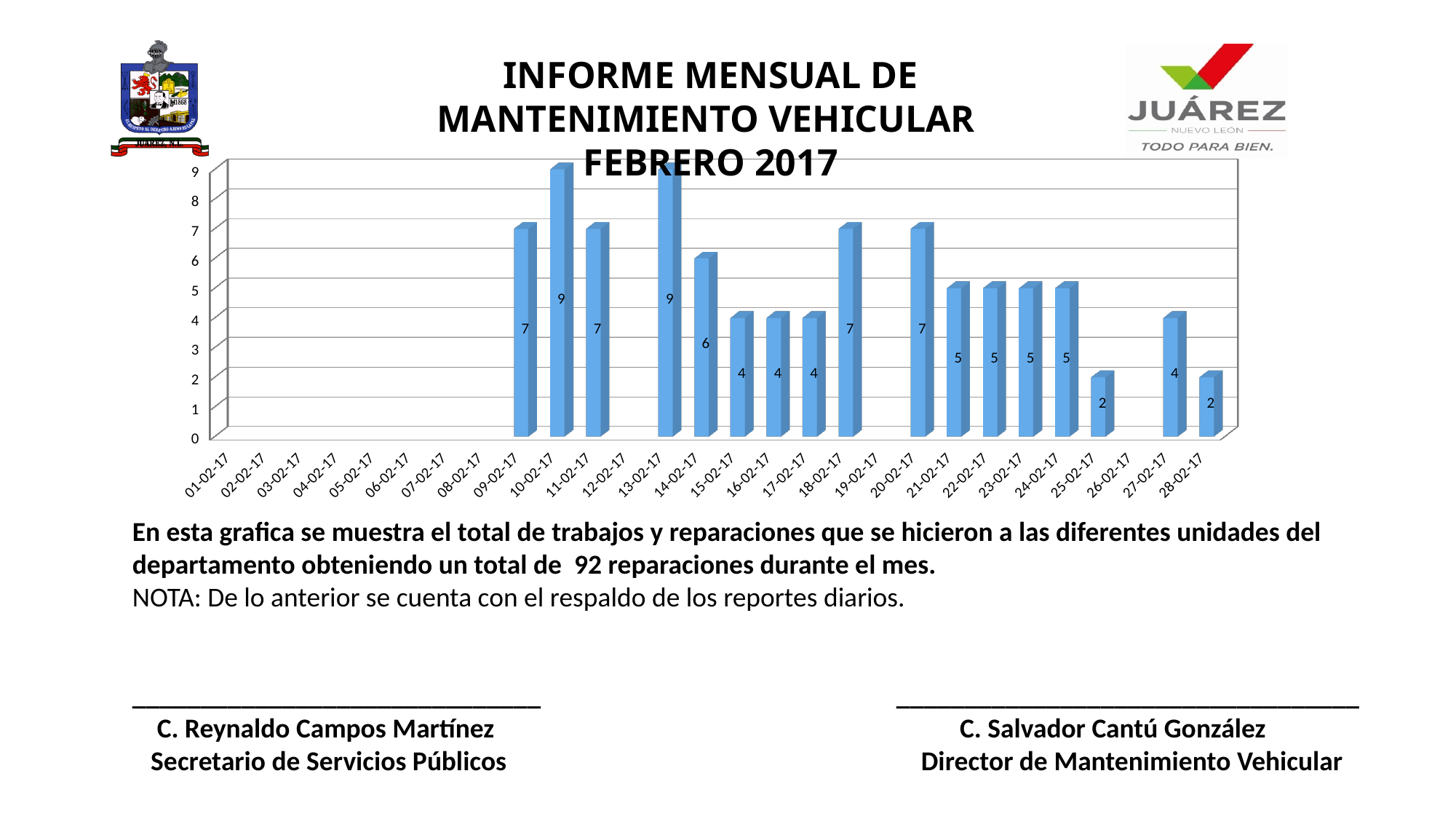
What type of chart is shown on the slide? bar chart What is the value for 27-02-17? 4 How many dates are listed along the x axis? 28 What is the highest value shown by any bar in the chart? 9 What is the value for 18-02-17? 7 What is the difference between the values for 10-02-17 and 14-02-17? 3 What is the value for 25-02-17? 2 Which two dates share the highest value in the chart? 10-02-17 and 13-02-17 Which is larger, the value for 21-02-17 or the value for 15-02-17? 21-02-17 Do the values rise or fall from 21-02-17 to 25-02-17? fall What is the difference between the values for 09-02-17 and 28-02-17? 5 What is the value for 14-02-17? 6